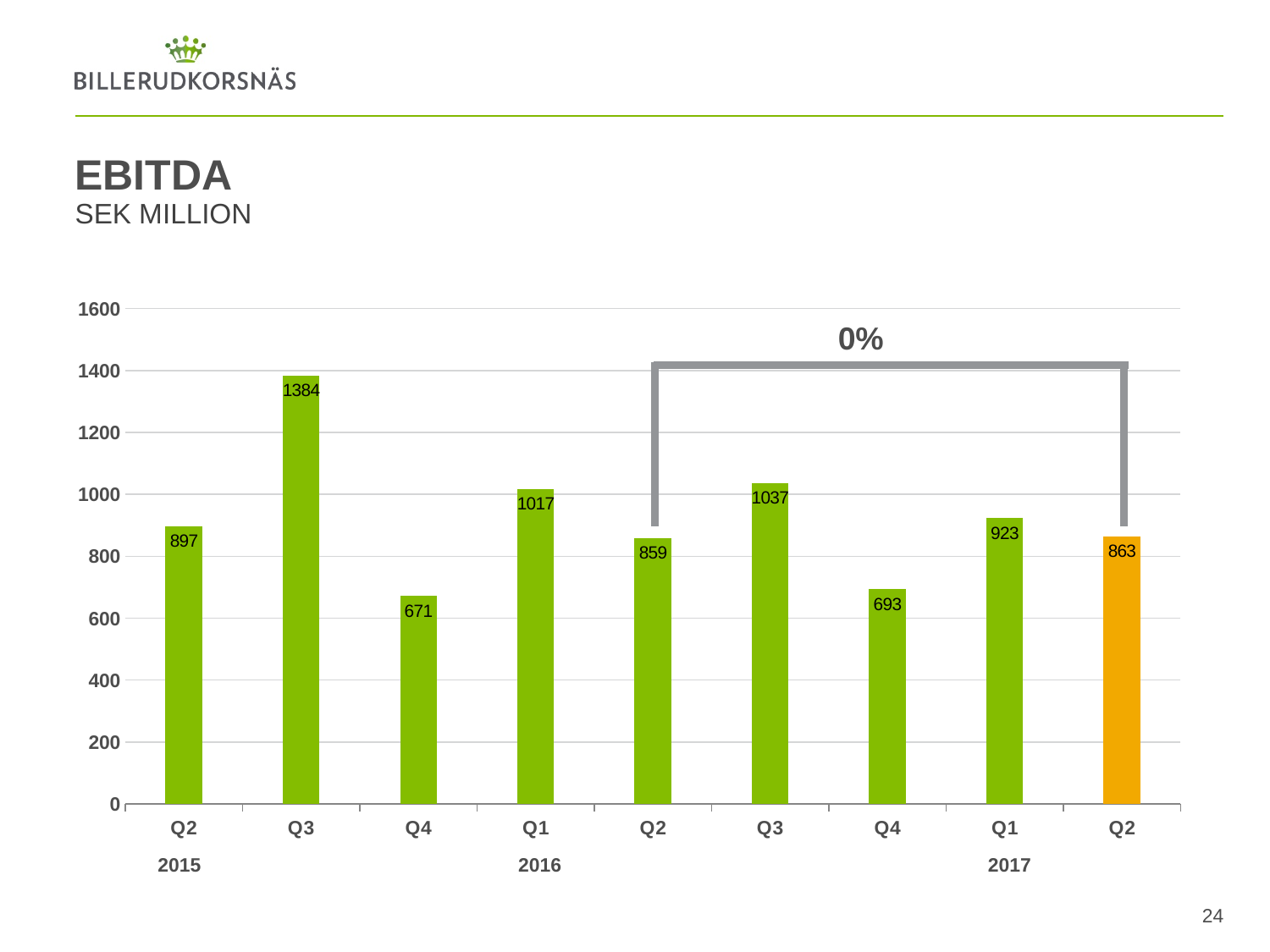
What is the difference in EBITDA between Q3 2016 and Q2 2016? 178 What is the EBITDA value for Q3 2015? 1384 What kind of chart is shown on the slide? bar chart Which quarter has the lowest EBITDA? Q4 2015 What is the EBITDA value for Q4 2016? 693 Is the EBITDA value for Q4 2015 greater or less than 800? less Which is larger, the EBITDA for Q1 2016 or Q3 2016? Q3 2016 How many quarters are shown in the chart? 9 What is the EBITDA value for Q2 2017? 863 What percentage change is shown between Q2 2016 and Q2 2017? 0% What is the difference in EBITDA between Q1 2017 and Q2 2017? 60 Which quarter has the highest EBITDA? Q3 2015